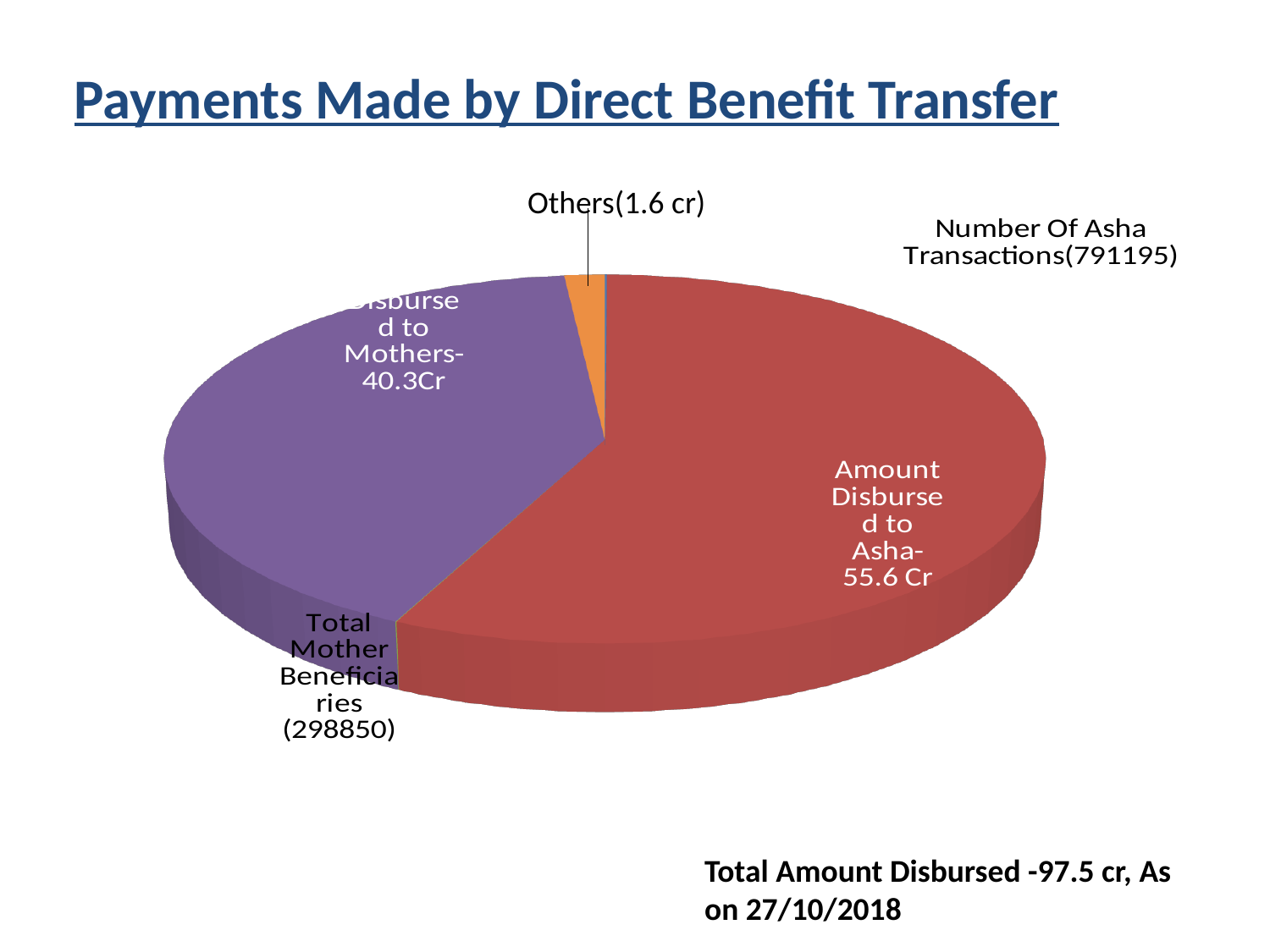
How many slices does the pie chart have? 3 What is the amount disbursed to Asha according to the pie chart? 55.6 Cr What is the total amount disbursed as stated on the slide? 97.5 cr What type of chart is shown on the slide? Pie chart What is the amount disbursed to Mothers according to the pie chart? 40.3Cr What colour is the slice for the amount disbursed to Mothers? Purple What is the value of the Others slice in the pie chart? 1.6 cr Which is larger: the amount disbursed to Asha or the amount disbursed to Mothers? Amount Disbursed to Asha Which slice of the pie chart is the largest? Amount Disbursed to Asha What is the title of the slide's chart? Payments Made by Direct Benefit Transfer What is the difference between the amount disbursed to Asha and the amount disbursed to Mothers? 15.3 Cr Which slice of the pie chart is the smallest? Others